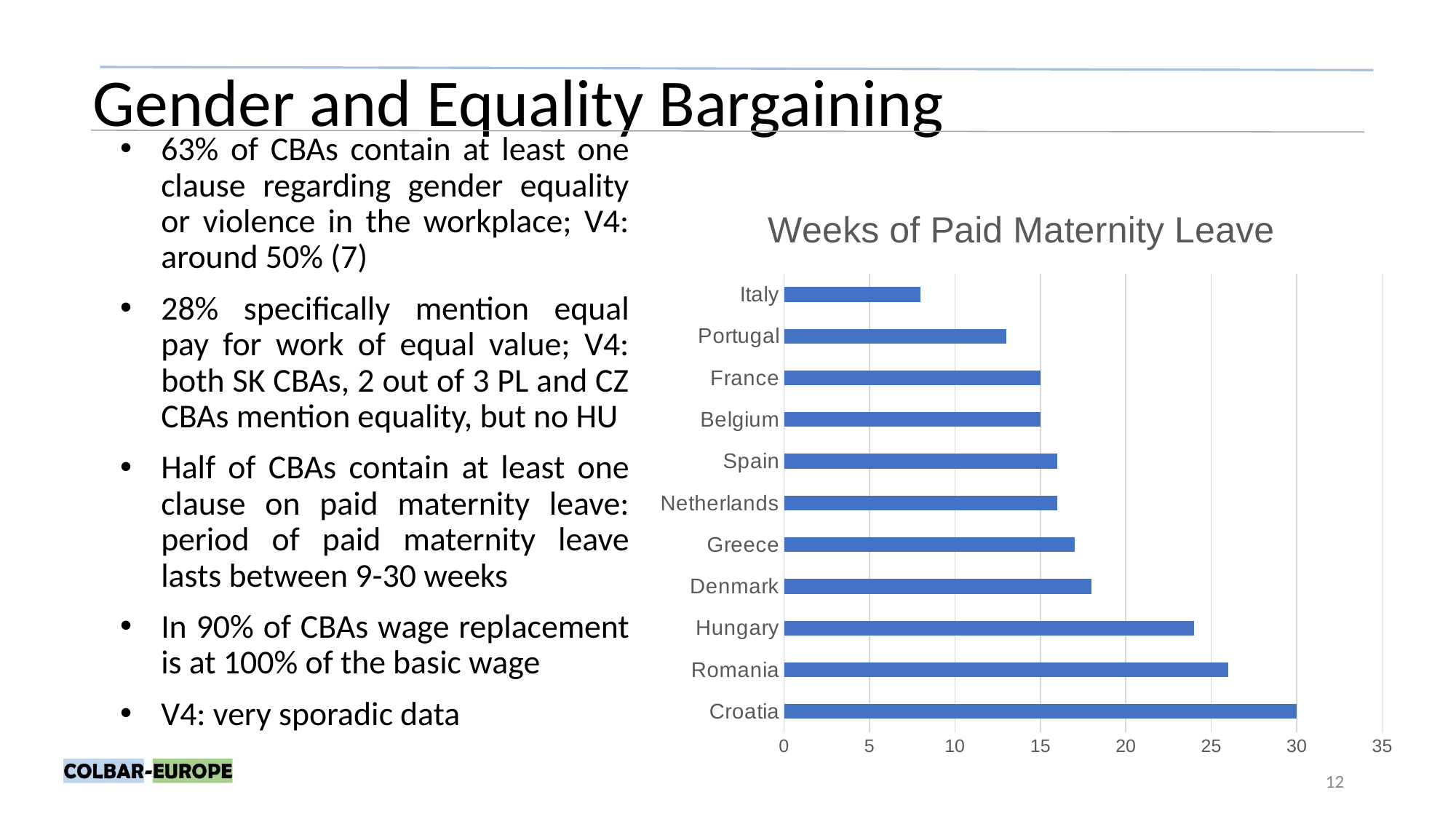
Which country has the lowest number of weeks of paid maternity leave? Italy Is the value for Hungary greater or less than 20? greater Which country has the highest number of weeks of paid maternity leave? Croatia Which has more weeks of paid maternity leave, Hungary or Denmark? Hungary Is the value for Italy greater or less than 10? less How many weeks of paid maternity leave does Croatia have? 30 Which has more weeks of paid maternity leave, Romania or Greece? Romania What is the title of the chart? Weeks of Paid Maternity Leave Is the value for Portugal greater or less than 10? greater How many countries are shown in the chart? 11 What kind of chart is shown on the slide? bar chart